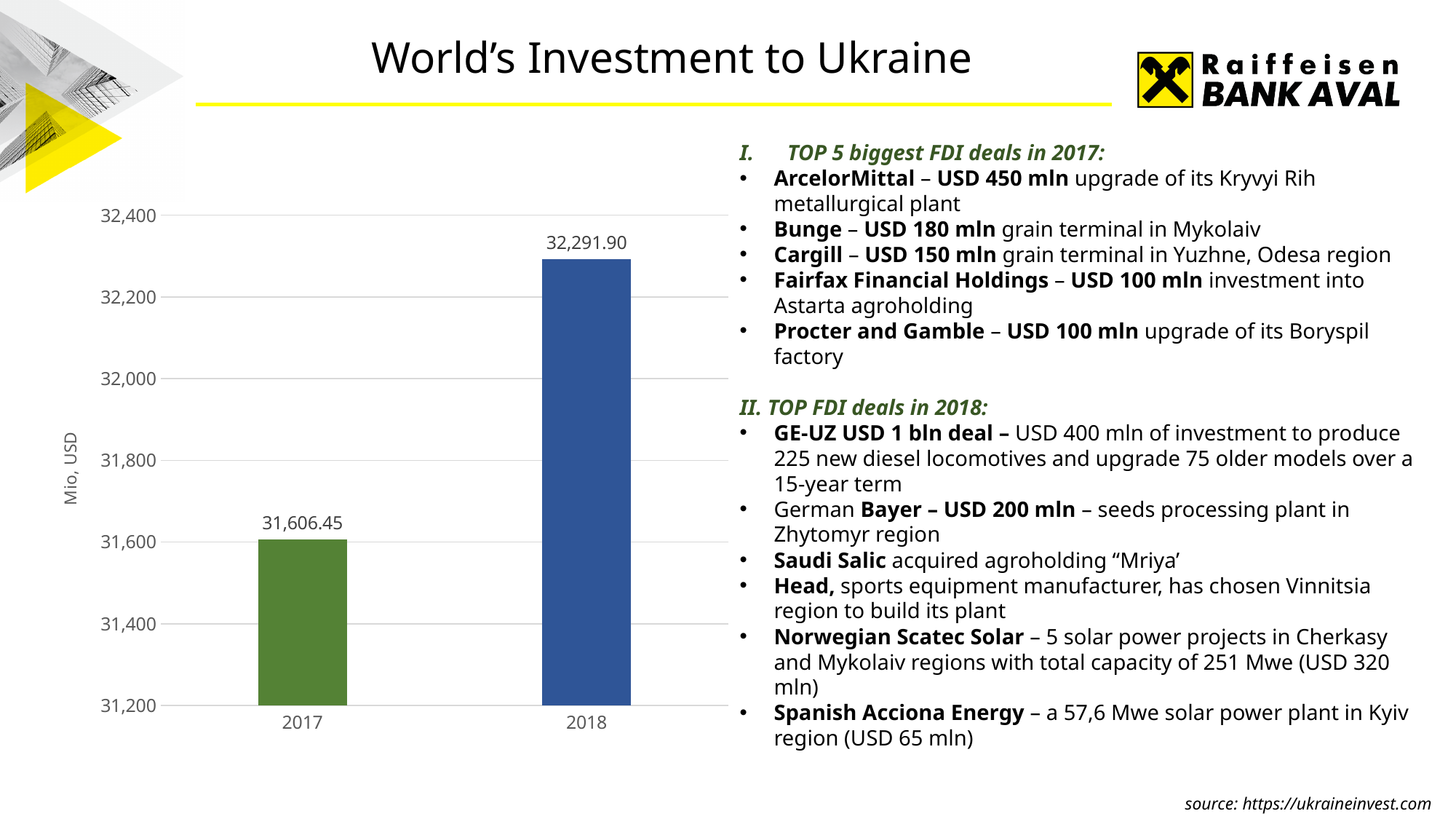
Do the values rise or fall from 2017 to 2018? rise How many bars are shown in the chart? 2 Which year has the higher value? 2018 What is the difference between the 2018 and 2017 values? 685.45 What is the value for 2018? 32,291.90 Is the value for 2017 greater or less than 31,800? less What kind of chart is shown on the slide? bar chart What is the label on the vertical axis of the chart? Mio, USD What colour is the bar for 2018? blue What is the value for 2017? 31,606.45 Is the value for 2018 greater or less than 32,200? greater Which year has the lower value? 2017